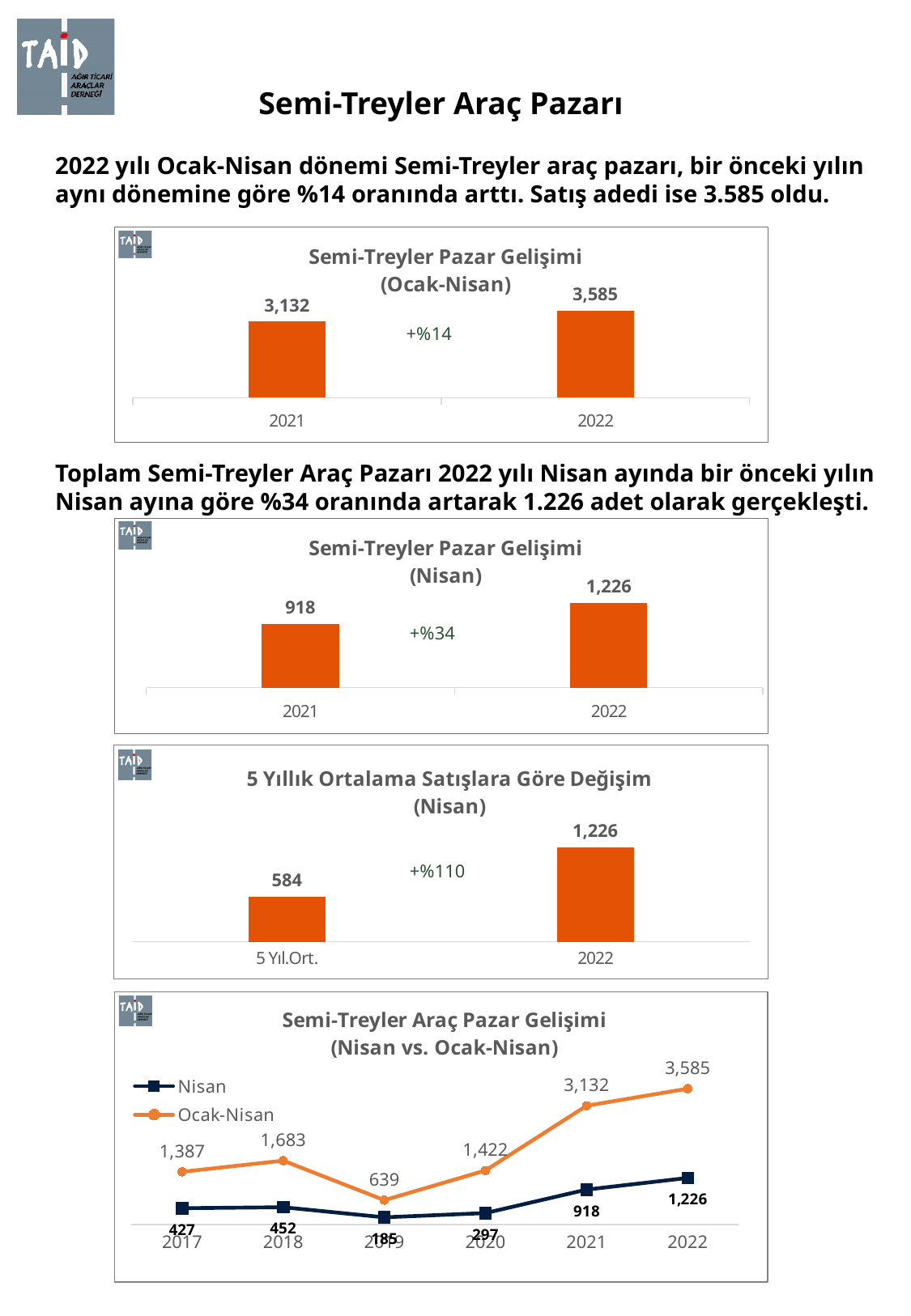
In the bottom chart 'Semi-Treyler Araç Pazar Gelişimi (Nisan vs. Ocak-Nisan)', what is the Ocak-Nisan value for 2018? 1,683 In the chart titled '5 Yıllık Ortalama Satışlara Göre Değişim (Nisan)', which category has the higher value, '5 Yıl.Ort.' or 2022? 2022 In the bottom chart 'Semi-Treyler Araç Pazar Gelişimi (Nisan vs. Ocak-Nisan)', how many years are shown on the x axis? 6 In the chart titled 'Semi-Treyler Pazar Gelişimi (Nisan)', what percentage change is shown between the two bars? +%34 In the bottom chart 'Semi-Treyler Araç Pazar Gelişimi (Nisan vs. Ocak-Nisan)', what is the difference between the Ocak-Nisan and Nisan values for 2020? 1,125 What kind of chart is the bottom chart titled 'Semi-Treyler Araç Pazar Gelişimi (Nisan vs. Ocak-Nisan)'? line chart In the bottom chart 'Semi-Treyler Araç Pazar Gelişimi (Nisan vs. Ocak-Nisan)', how many series does the legend list? 2 In the chart titled 'Semi-Treyler Pazar Gelişimi (Nisan)', what is the value for 2021? 918 In the chart titled 'Semi-Treyler Pazar Gelişimi (Ocak-Nisan)', what is the difference between the 2022 and 2021 values? 453 In the bottom chart 'Semi-Treyler Araç Pazar Gelişimi (Nisan vs. Ocak-Nisan)', which year has the lowest Ocak-Nisan value? 2019 In the chart titled 'Semi-Treyler Pazar Gelişimi (Ocak-Nisan)', what is the value for 2022? 3,585 In the chart titled '5 Yıllık Ortalama Satışlara Göre Değişim (Nisan)', what is the value for '5 Yıl.Ort.'? 584